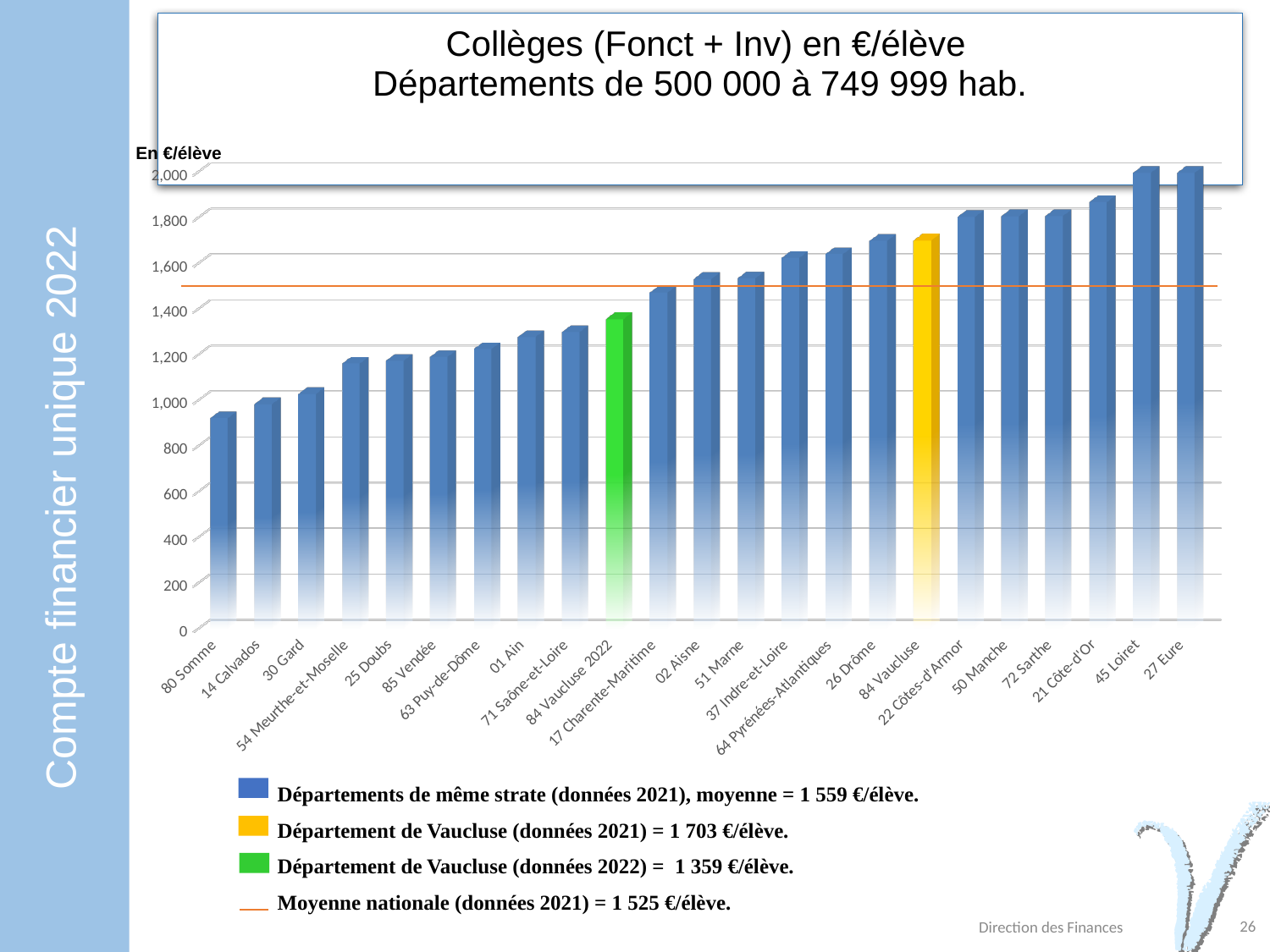
What is the value for Département de Vaucluse (données 2022)? 1 359 €/élève Which has the larger value, 30 Gard or 25 Doubs? 25 Doubs How many departments (bars) are plotted in the chart? 23 Is the value for 80 Somme greater or less than 1,000? less What colour is the bar for 84 Vaucluse 2022? green What kind of chart is shown on the slide? bar chart Do the bar values rise or fall from left to right along the x axis? rise Which department has the lowest value in the chart? 80 Somme What is the difference between the Vaucluse 2021 value and the Vaucluse 2022 value? 344 €/élève Is the value for 17 Charente-Maritime greater or less than 1,600? less What value does the orange horizontal line (Moyenne nationale, données 2021) represent? 1 525 €/élève What is the value for Département de Vaucluse (données 2021)? 1 703 €/élève